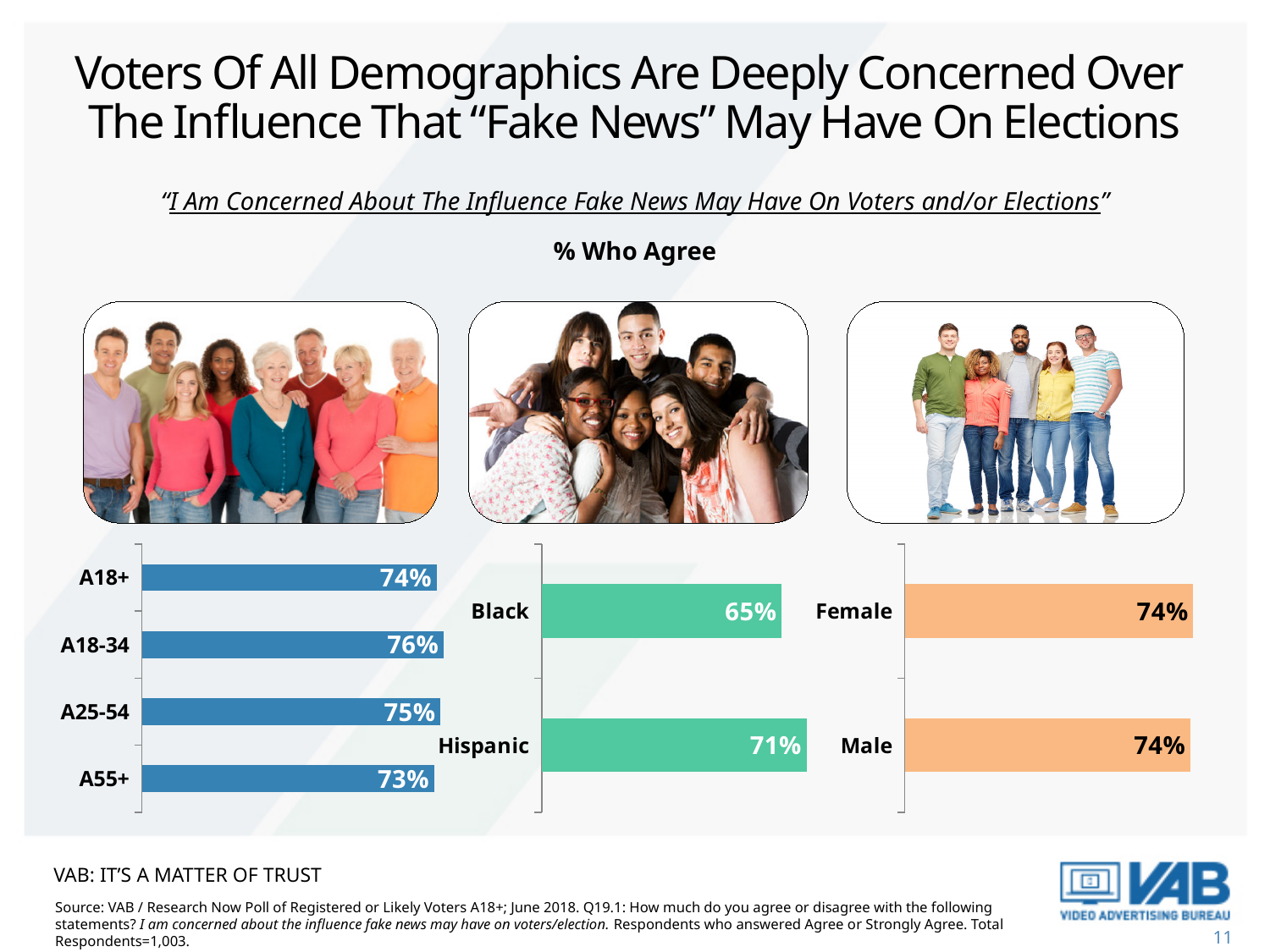
In the left chart (age groups), what is the difference between A18-34 and A55+? 3% In the left chart (age groups), what is the value for A18-34? 76% In the middle chart (ethnicity), which is larger, Black or Hispanic? Hispanic In the left chart (age groups), which category has the lowest value? A55+ What kind of chart is the left chart (age groups)? Bar chart In the middle chart (ethnicity), what is the value for Black? 65% In the left chart (age groups), how many categories are shown? 4 In the middle chart (ethnicity), what is the difference between Hispanic and Black? 6% In the right chart (gender), what is the value for Male? 74% In the left chart (age groups), which category has the highest value? A18-34 In the left chart (age groups), what is the value for A55+? 73% In the right chart (gender), what is the difference between Female and Male? 0%